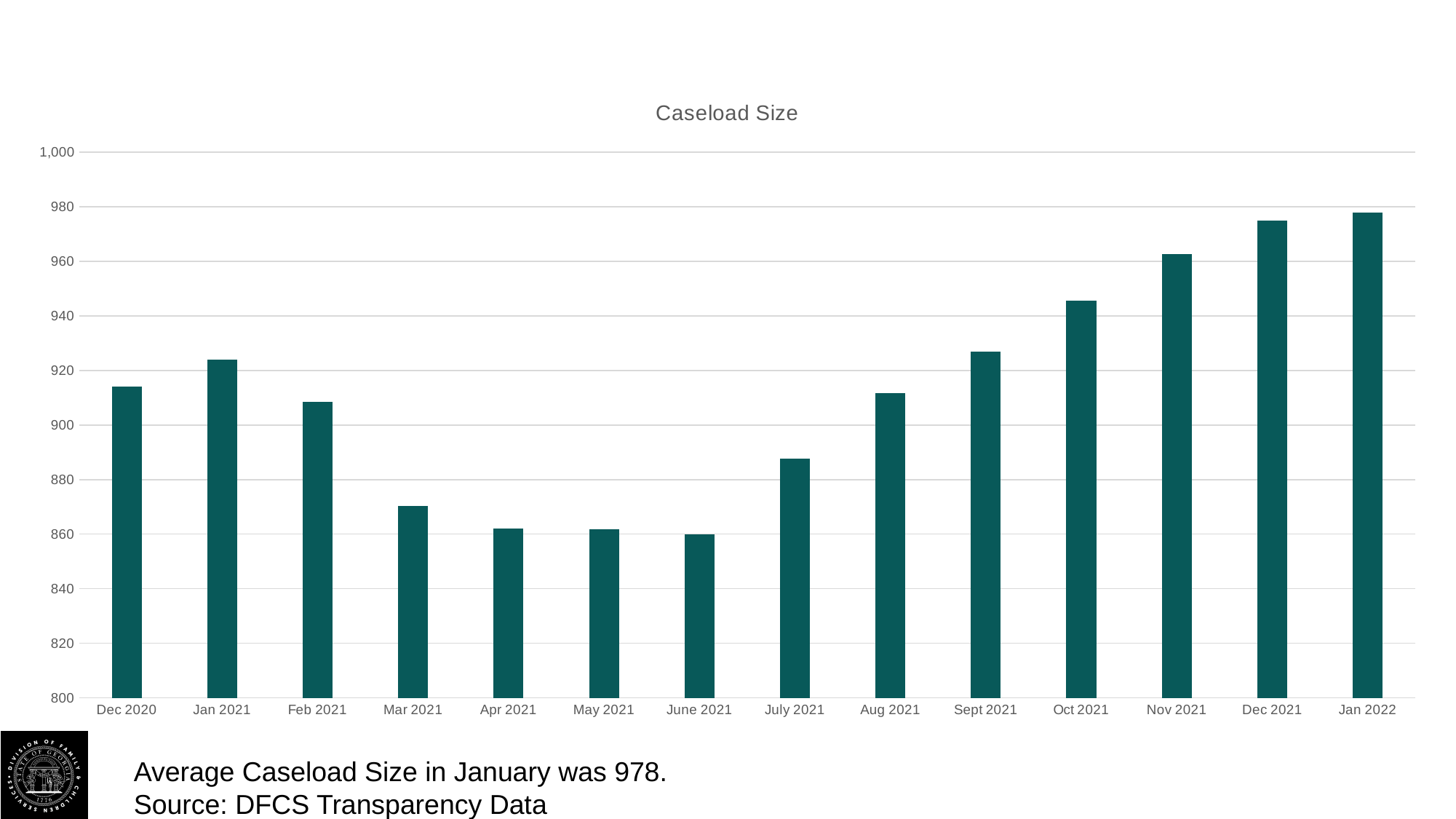
Is the caseload size for Dec 2020 greater or less than 900? greater Which is larger, the caseload size for Jan 2021 or for Feb 2021? Jan 2021 Is the caseload size for Mar 2021 greater or less than 880? less What source is cited for the chart data? DFCS Transparency Data Is the caseload size for July 2021 greater or less than 900? less How many months are plotted on the x axis of the chart? 14 Which month has the highest caseload size? Jan 2022 Do the caseload sizes rise or fall from June 2021 to Jan 2022? rise What was the average caseload size in Jan 2022, according to the slide? 978 What is the title of the chart? Caseload Size What kind of chart is shown on the slide? bar chart